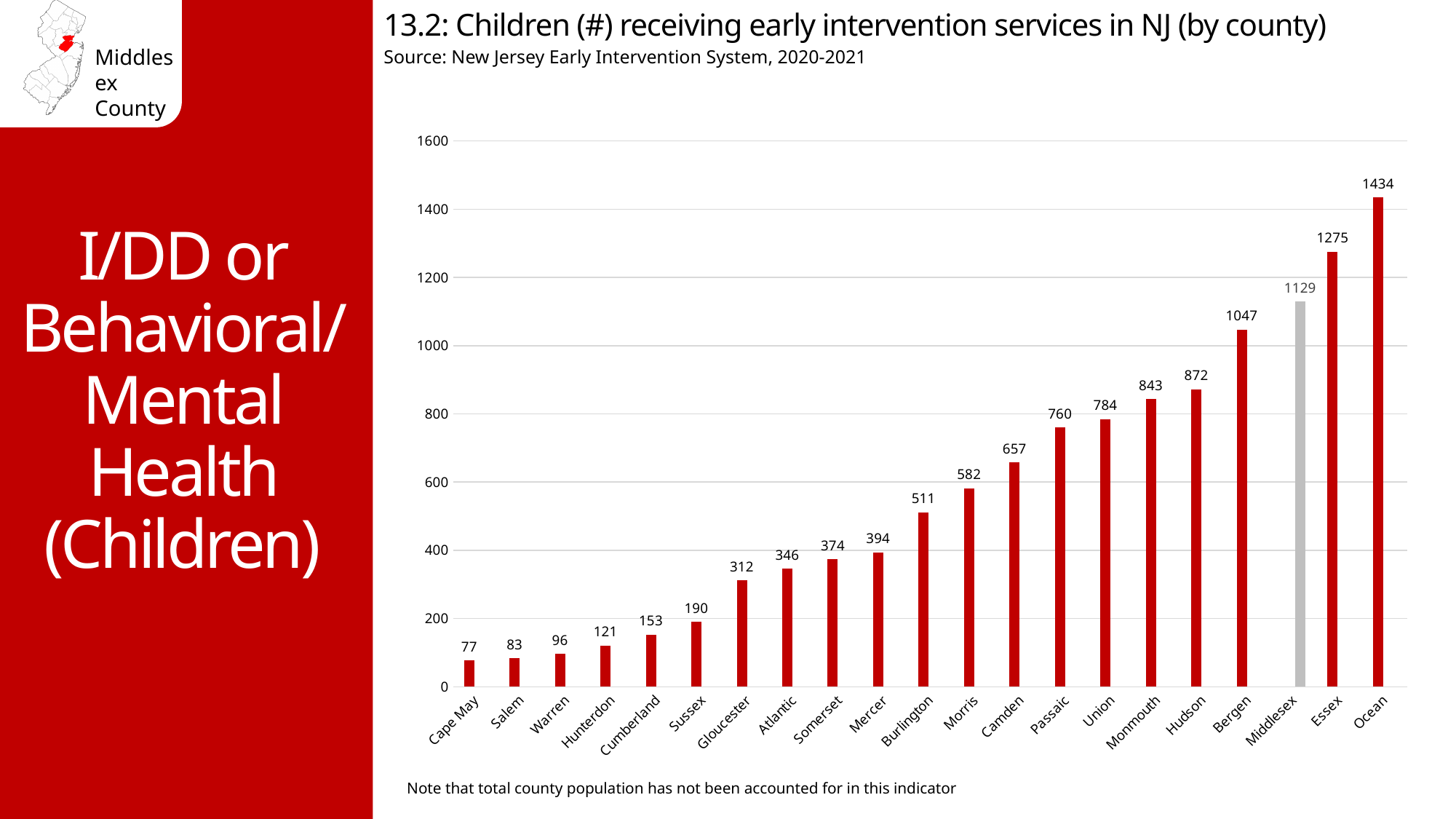
Which county has a larger value, Hudson or Monmouth? Hudson Is the value for Passaic greater or less than 800? less How many counties are shown on the chart? 21 Which county has the lowest number of children receiving early intervention services? Cape May Which county's bar is coloured grey instead of red? Middlesex What is the difference between the values for Ocean and Essex? 159 What is the value shown for Sussex County? 190 Do the values rise or fall moving from left to right along the x axis? Rise Which county has the highest number of children receiving early intervention services? Ocean What is the value shown for Bergen County? 1047 What kind of chart is shown on the slide? Bar chart How many children received early intervention services in Middlesex County? 1129